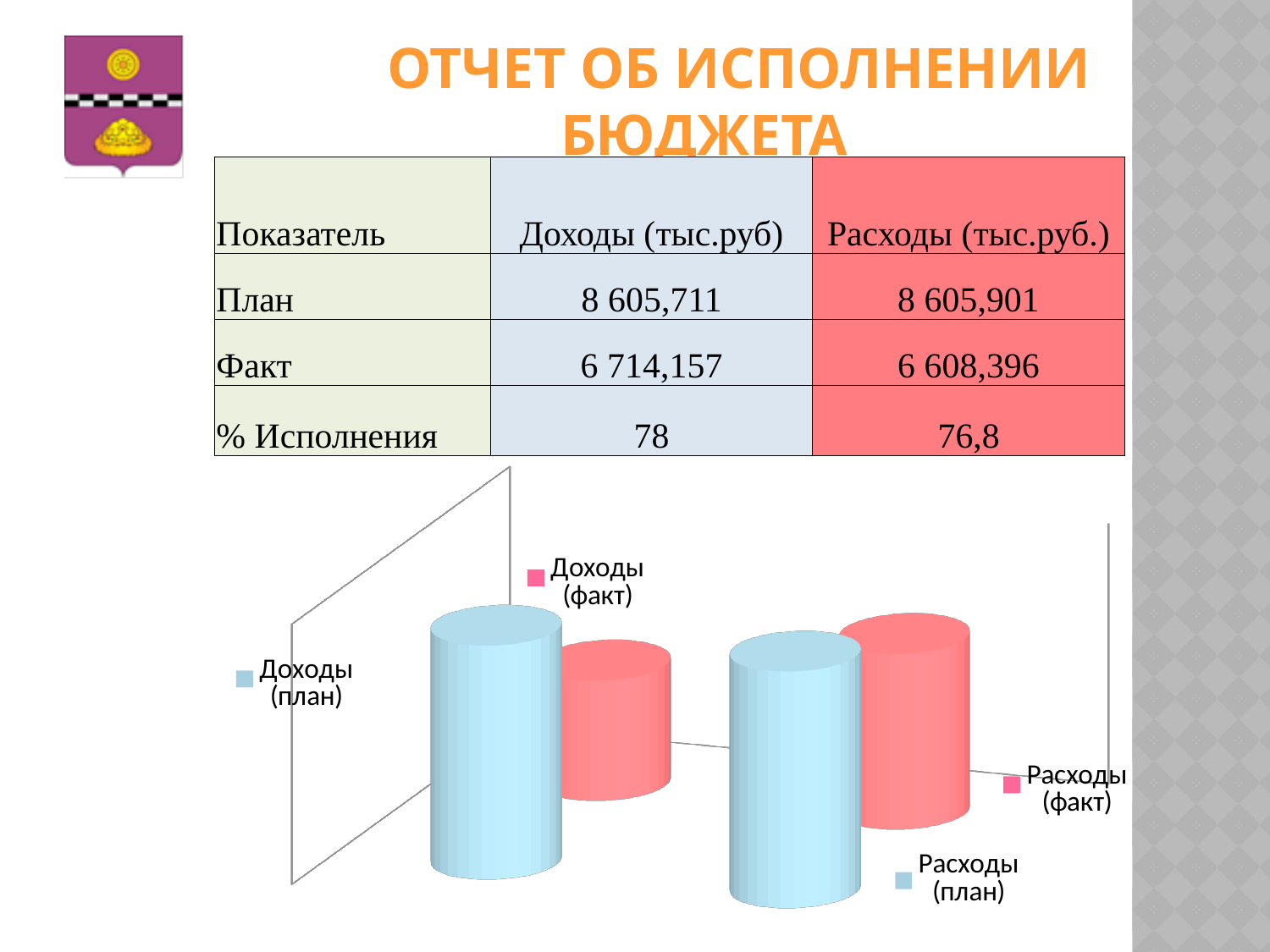
How many bars does the chart contain? 4 What colour are the Доходы (план) and Расходы (план) bars? light blue Which bar is taller, Расходы (план) or Расходы (факт)? Расходы (план) According to the table on the slide, what is the value of Доходы (тыс.руб) for Факт? 6 714,157 According to the table on the slide, what is the value of Доходы (тыс.руб) for План? 8 605,711 What kind of chart is shown on the slide? bar chart Which bar is taller, Доходы (план) or Доходы (факт)? Доходы (план) According to the table on the slide, what is the % Исполнения for Расходы? 76,8 What colour are the Доходы (факт) and Расходы (факт) bars? pink According to the table on the slide, what is the value of Расходы (тыс.руб.) for Факт? 6 608,396 According to the table on the slide, what is the % Исполнения for Доходы? 78